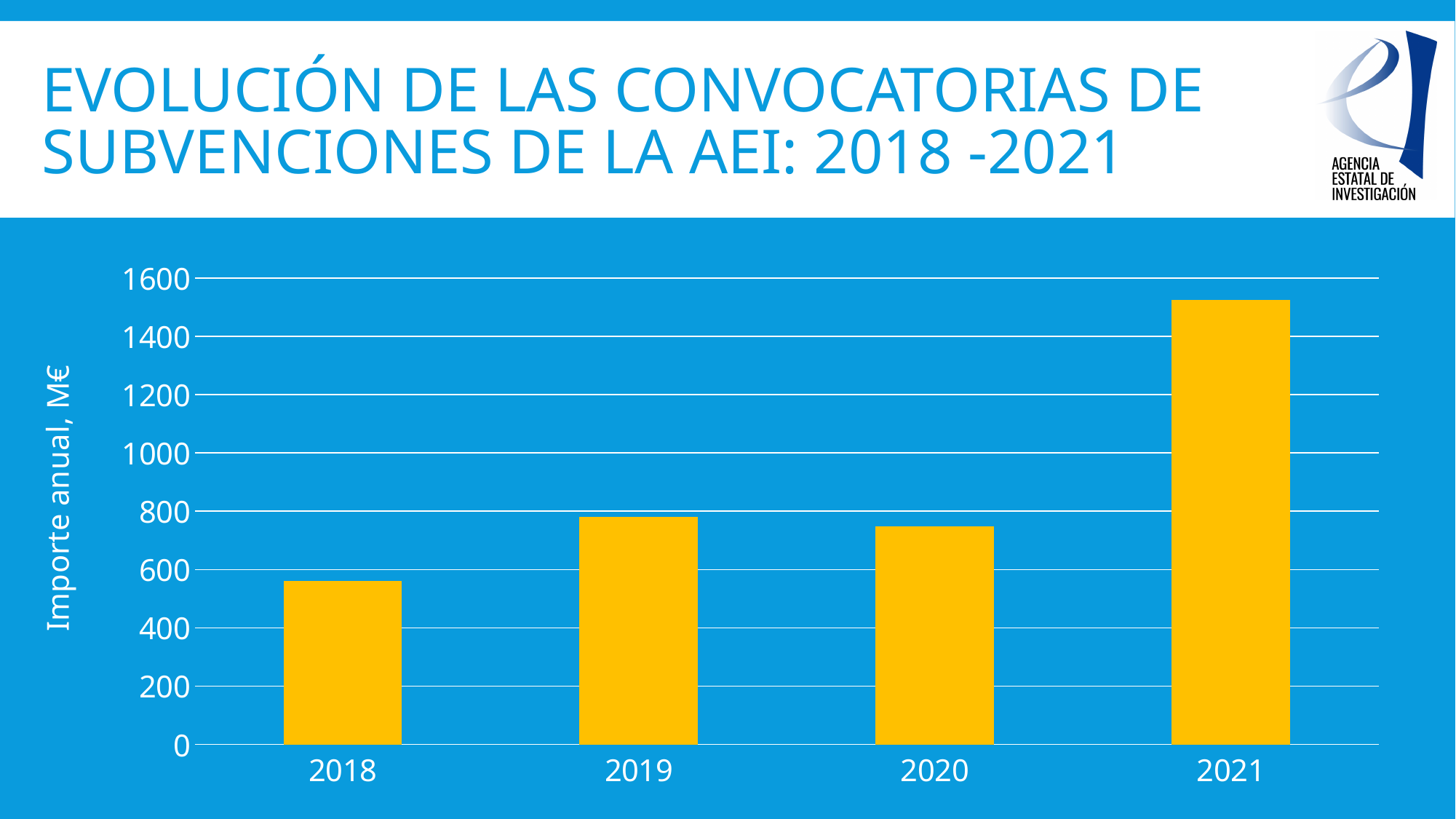
How many years are shown on the x axis of the chart? 4 Is the value for 2021 greater or less than 1400? greater Which year has the highest value in the chart? 2021 Which year has the lowest value in the chart? 2018 What is the label of the vertical axis of the chart? Importe anual, M€ What kind of chart is shown on the slide? Bar chart Is the value for 2020 greater or less than 800? less Which is larger, the value for 2021 or the value for 2019? 2021 Does the value rise or fall from 2020 to 2021? rise Is the value for 2019 greater or less than 600? greater What is the title of the slide containing the chart? EVOLUCIÓN DE LAS CONVOCATORIAS DE SUBVENCIONES DE LA AEI: 2018 -2021